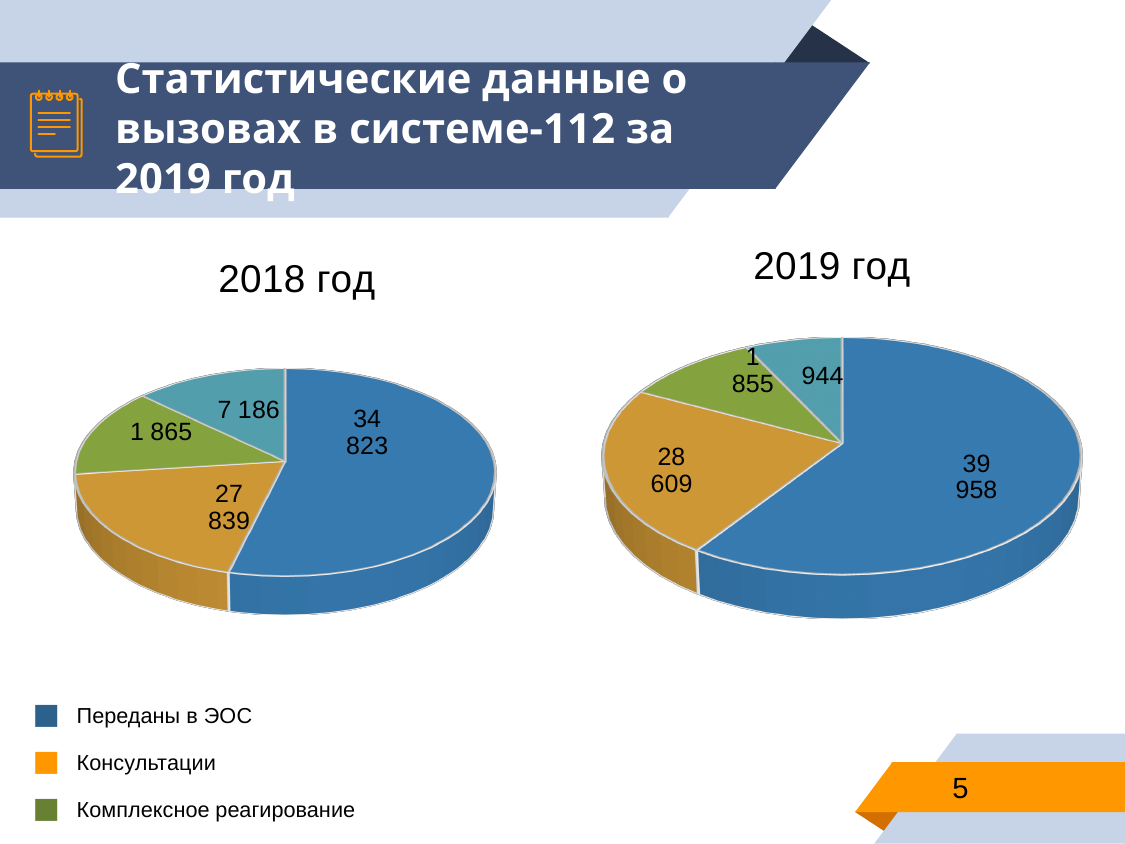
In the 2018 год chart, what is the value for Консультации? 27 839 How many slices does the 2019 год pie chart have? 4 How many entries does the legend list? 3 In the 2018 год chart, what is the value for Переданы в ЭОС? 34 823 In the 2018 год chart, what is the difference between Переданы в ЭОС and Консультации? 6 984 In the 2019 год chart, what is the value for Переданы в ЭОС? 39 958 Which is larger: Консультации in the 2018 год chart or Консультации in the 2019 год chart? 2019 год In the 2019 год chart, which category has the largest slice? Переданы в ЭОС In the 2019 год chart, what is the difference between Переданы в ЭОС and Консультации? 11 349 What type of chart is used for the 2018 год data? Pie chart In the 2019 год chart, what is the value for Комплексное реагирование? 1 855 In the 2018 год chart, which legend category has the smallest slice? Комплексное реагирование